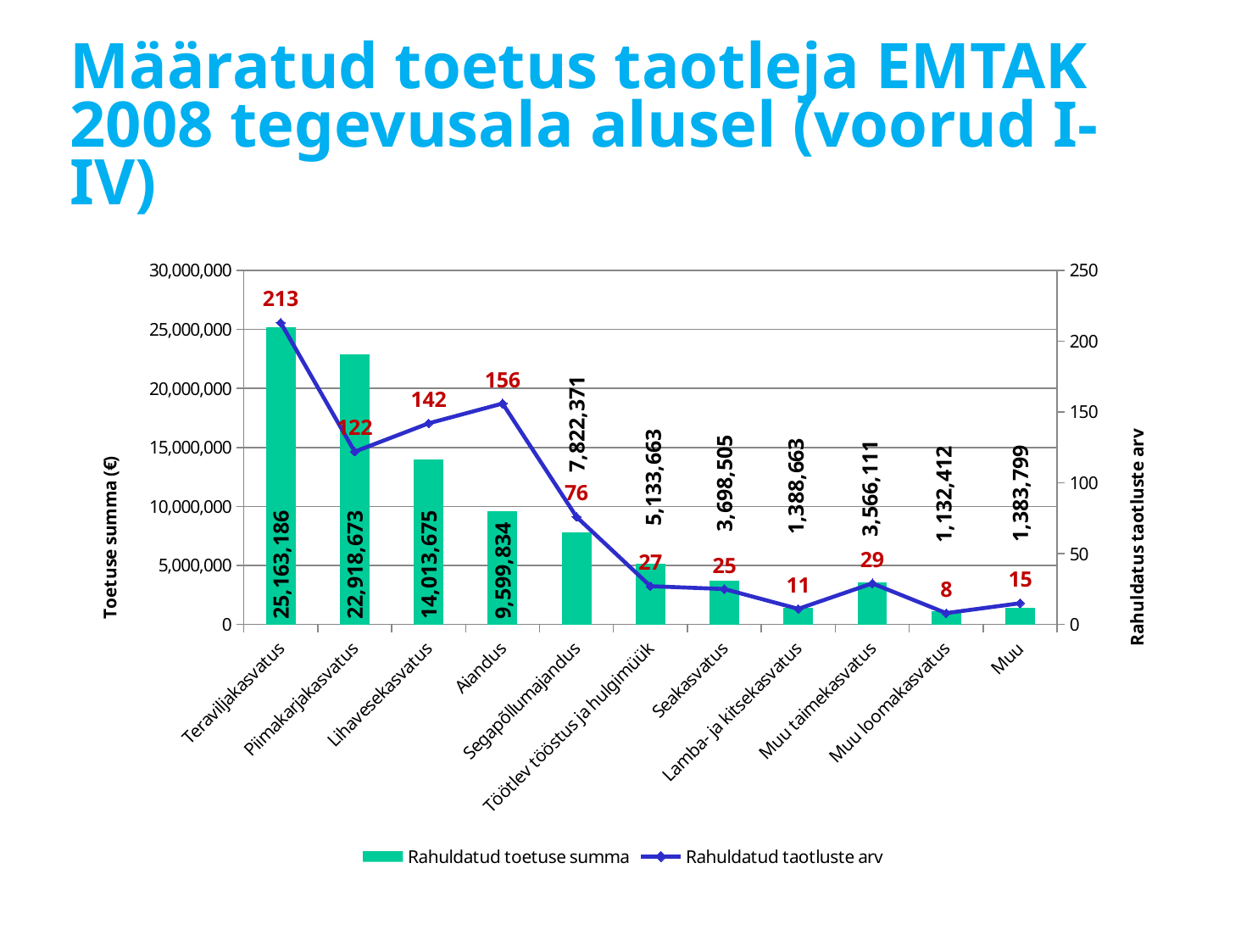
Which has a larger Rahuldatud toetuse summa, Lihaveisekasvatus or Aiandus? Lihavesekasvatus What is the Rahuldatud taotluste arv value for Aiandus? 156 Which category has the highest Rahuldatud taotluste arv? Teraviljakasvatus What is the Rahuldatud toetuse summa value for Seakasvatus? 3,698,505 How many series does the legend list? 2 Which has a larger Rahuldatud taotluste arv, Muu taimekasvatus or Seakasvatus? Muu taimekasvatus What is the difference in Rahuldatud taotluste arv between Teraviljakasvatus and Piimakarjakasvatus? 91 Which category has the lowest Rahuldatud taotluste arv? Muu loomakasvatus How many categories are shown on the x axis? 11 What is the Rahuldatud toetuse summa value for Teraviljakasvatus? 25,163,186 Which category has the lowest Rahuldatud toetuse summa? Muu loomakasvatus What kind of chart is used for the Rahuldatud toetuse summa series? Bar chart